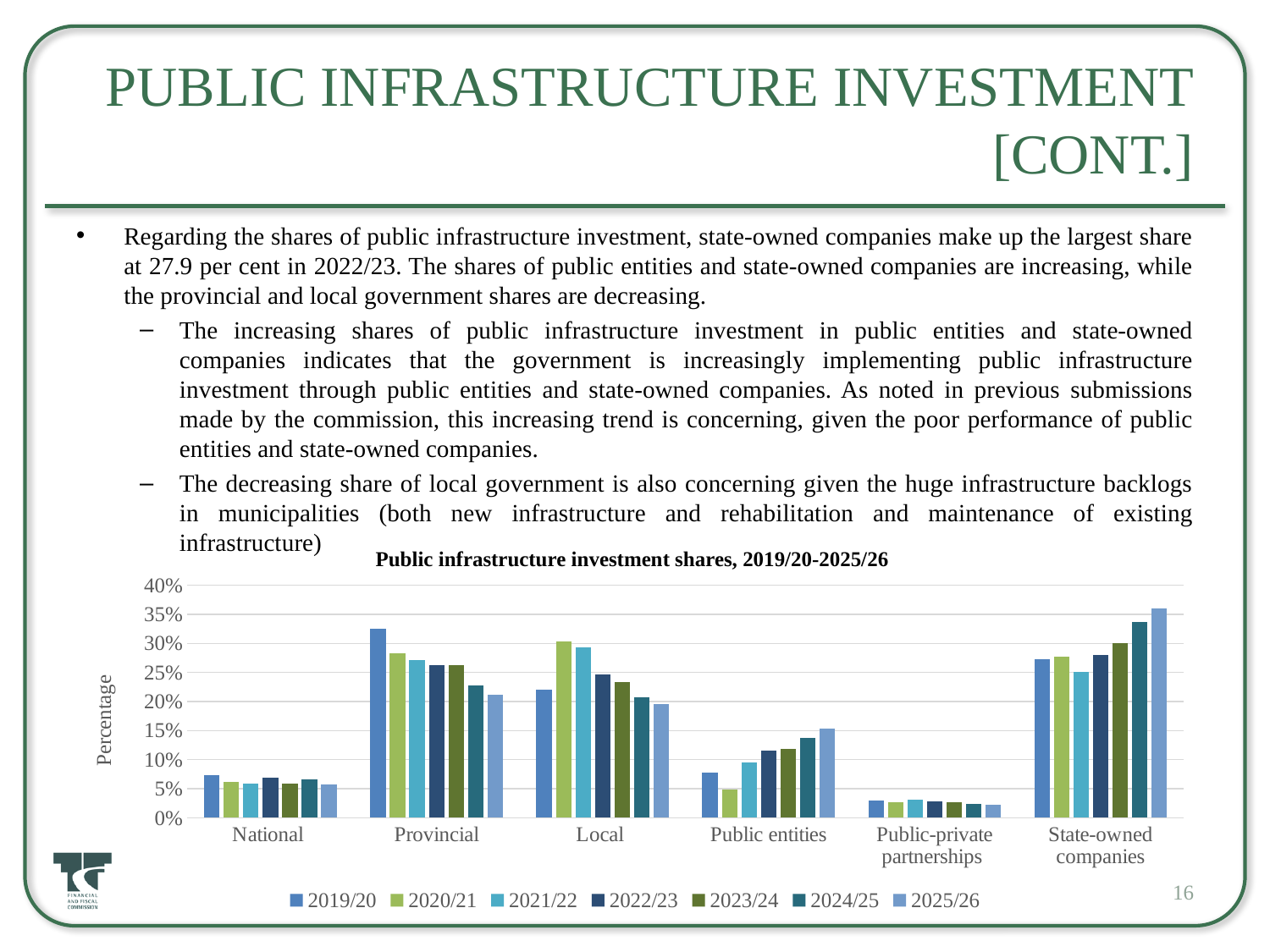
Is the value for Public-private partnerships in 2019/20 greater or less than 5%? less Which category has the lowest values across all years? Public-private partnerships What type of chart is shown on the slide? Bar chart How many series does the chart legend list? 7 What is the label of the vertical axis? Percentage Is the value for Provincial in 2019/20 greater or less than 30%? greater Do the values for Public entities rise or fall from 2021/22 to 2025/26? Rise Which category has the highest value for 2019/20? Provincial How many categories are shown on the x axis of the chart? 6 What is the title of the chart? Public infrastructure investment shares, 2019/20-2025/26 Which category has the highest value for 2025/26? State-owned companies